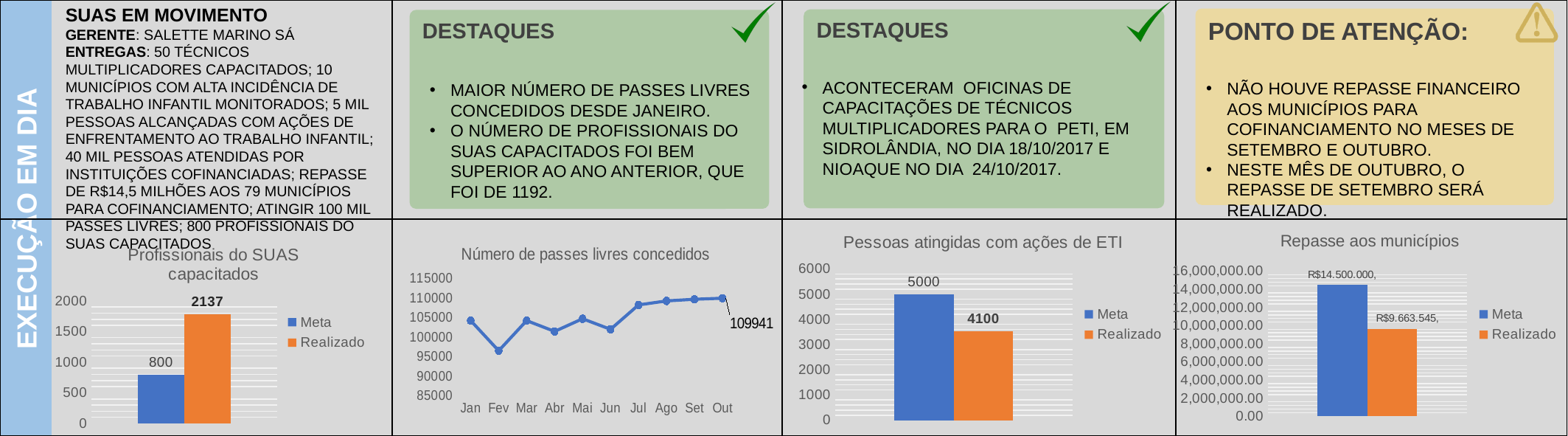
In the chart 'Profissionais do SUAS capacitados', what is the value for Meta? 800 In the chart 'Profissionais do SUAS capacitados', what is the difference between Realizado and Meta? 1337 In the chart 'Número de passes livres concedidos', which month has the lowest value? Fev In the chart 'Pessoas atingidas com ações de ETI', which is larger, Meta or Realizado? Meta In the chart 'Profissionais do SUAS capacitados', what is the value for Realizado? 2137 In the chart 'Número de passes livres concedidos', is the value for Fev greater or less than 100000? less In the chart 'Pessoas atingidas com ações de ETI', what is the value for Realizado? 4100 In the chart 'Repasse aos municípios', what is the value for Meta? R$14.500.000 In the chart 'Número de passes livres concedidos', what is the value for Out? 109941 What kind of chart is 'Número de passes livres concedidos'? line chart How many series does the legend of the chart 'Repasse aos municípios' list? 2 In the chart 'Número de passes livres concedidos', how many months are plotted on the x axis? 10